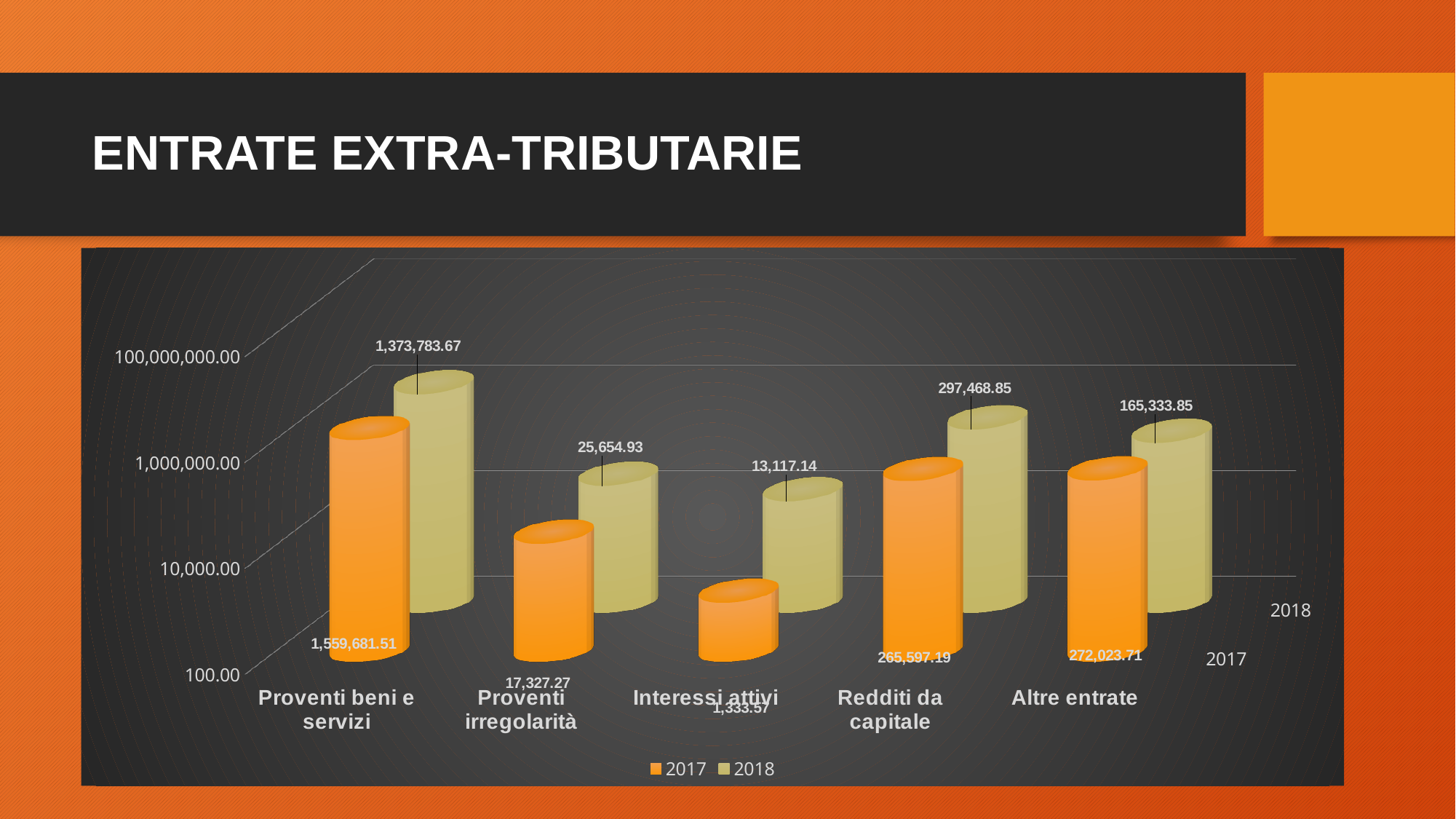
How many series does the legend list? 2 For Altre entrate, which year has the larger value, 2017 or 2018? 2017 What is the 2018 value for Redditi da capitale? 297,468.85 What is the 2017 value for Proventi beni e servizi? 1,559,681.51 Which category has the lowest 2017 value? Interessi attivi What is the difference between the 2017 and 2018 values for Proventi beni e servizi? 185,897.84 How many categories are shown on the x axis? 5 Which category has the highest 2018 value? Proventi beni e servizi What is the 2017 value for Altre entrate? 272,023.71 What is the 2018 value for Interessi attivi? 13,117.14 What is the difference between the 2018 and 2017 values for Interessi attivi? 11,783.57 What kind of chart is shown on the slide? Bar chart